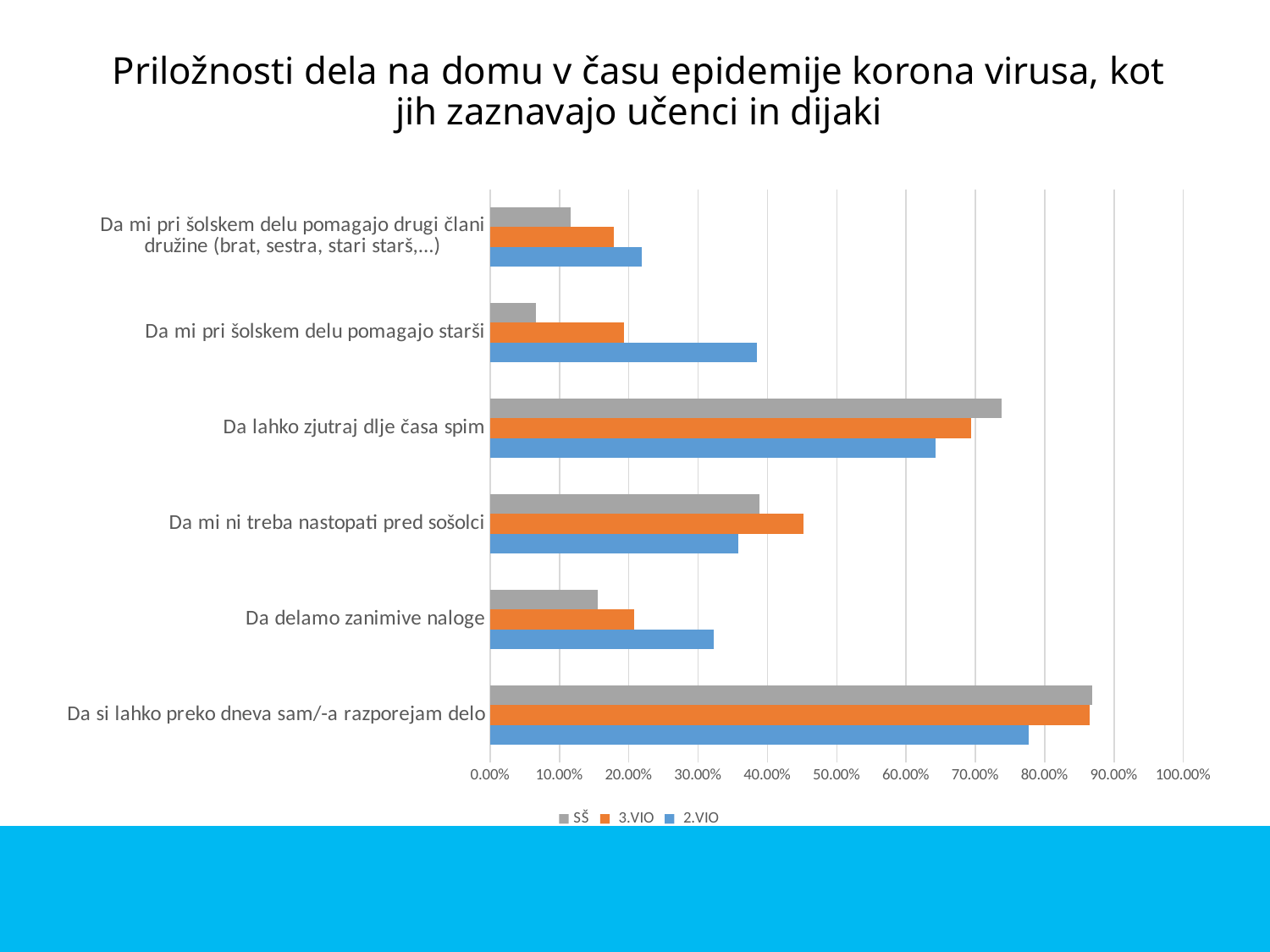
Is the 2.VIO value for 'Da delamo zanimive naloge' greater or less than 20.00%? greater Which category has the highest value for the SŠ series? Da si lahko preko dneva sam/-a razporejam delo Is the SŠ value for 'Da lahko zjutraj dlje časa spim' greater or less than 70.00%? greater What kind of chart is shown on the slide? Bar chart Which category has the lowest value for the SŠ series? Da mi pri šolskem delu pomagajo starši How many categories are plotted on the chart? 6 For 'Da mi pri šolskem delu pomagajo starši', which series has the larger value, 2.VIO or SŠ? 2.VIO How many series does the legend list? 3 Is the 3.VIO value for 'Da si lahko preko dneva sam/-a razporejam delo' greater or less than 80.00%? greater Which series are listed in the legend? SŠ, 3.VIO, 2.VIO For 'Da mi ni treba nastopati pred sošolci', which series has the larger value, 3.VIO or 2.VIO? 3.VIO Which category has the highest value for the 2.VIO series? Da si lahko preko dneva sam/-a razporejam delo